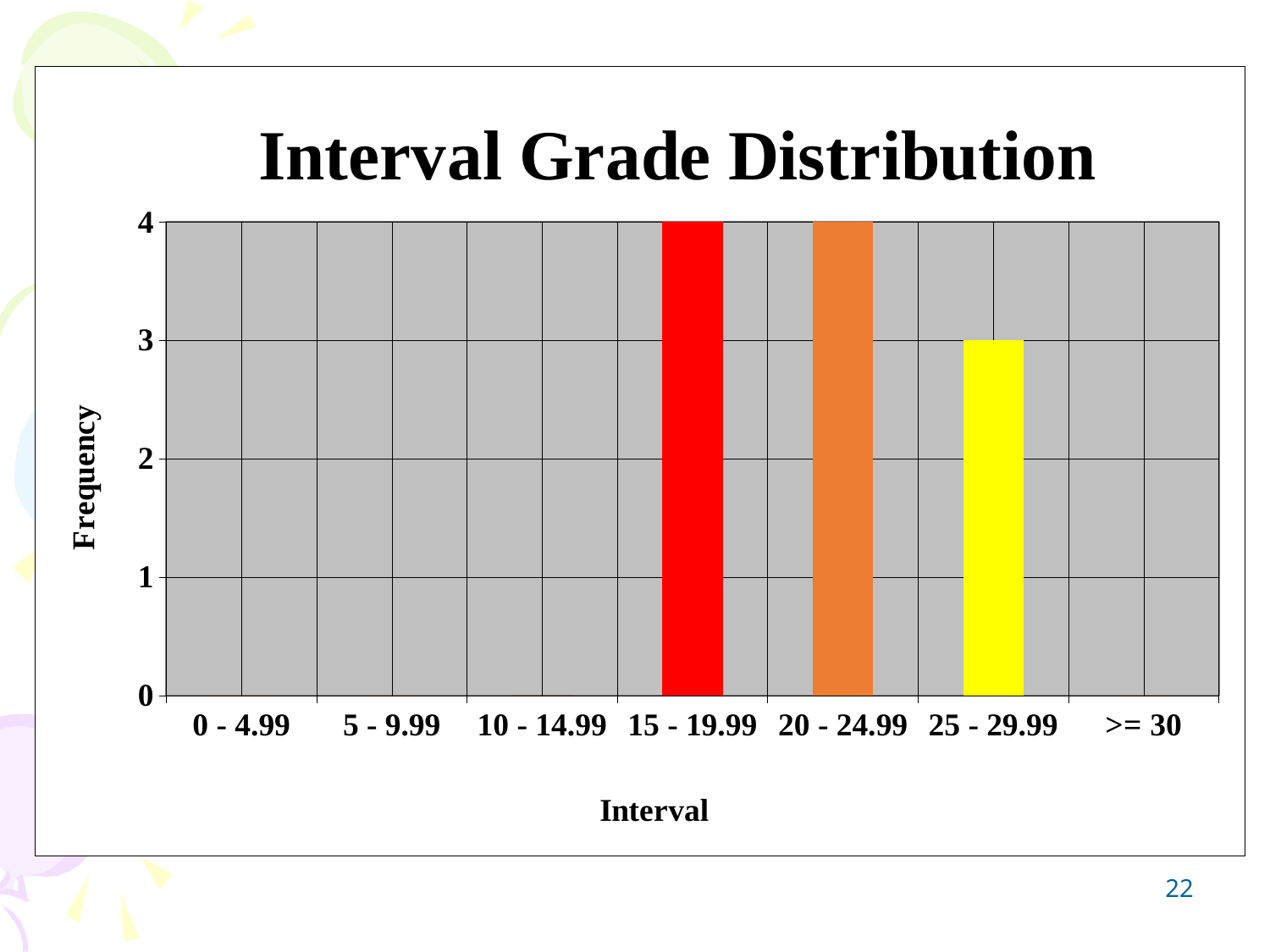
What is the frequency for the 15 - 19.99 interval? 4 What is the frequency for the 20 - 24.99 interval? 4 What kind of chart is shown on the slide? bar chart How many intervals are shown on the x axis? 7 Which has the higher frequency, the 15 - 19.99 interval or the 25 - 29.99 interval? 15 - 19.99 Is the frequency for the 25 - 29.99 interval greater or less than 2? greater What is the title of the chart? Interval Grade Distribution What is the frequency for the 25 - 29.99 interval? 3 What is the frequency for the 0 - 4.99 interval? 0 How many intervals have a frequency greater than 0? 3 What is the label of the vertical axis? Frequency What is the difference in frequency between the 20 - 24.99 interval and the 25 - 29.99 interval? 1